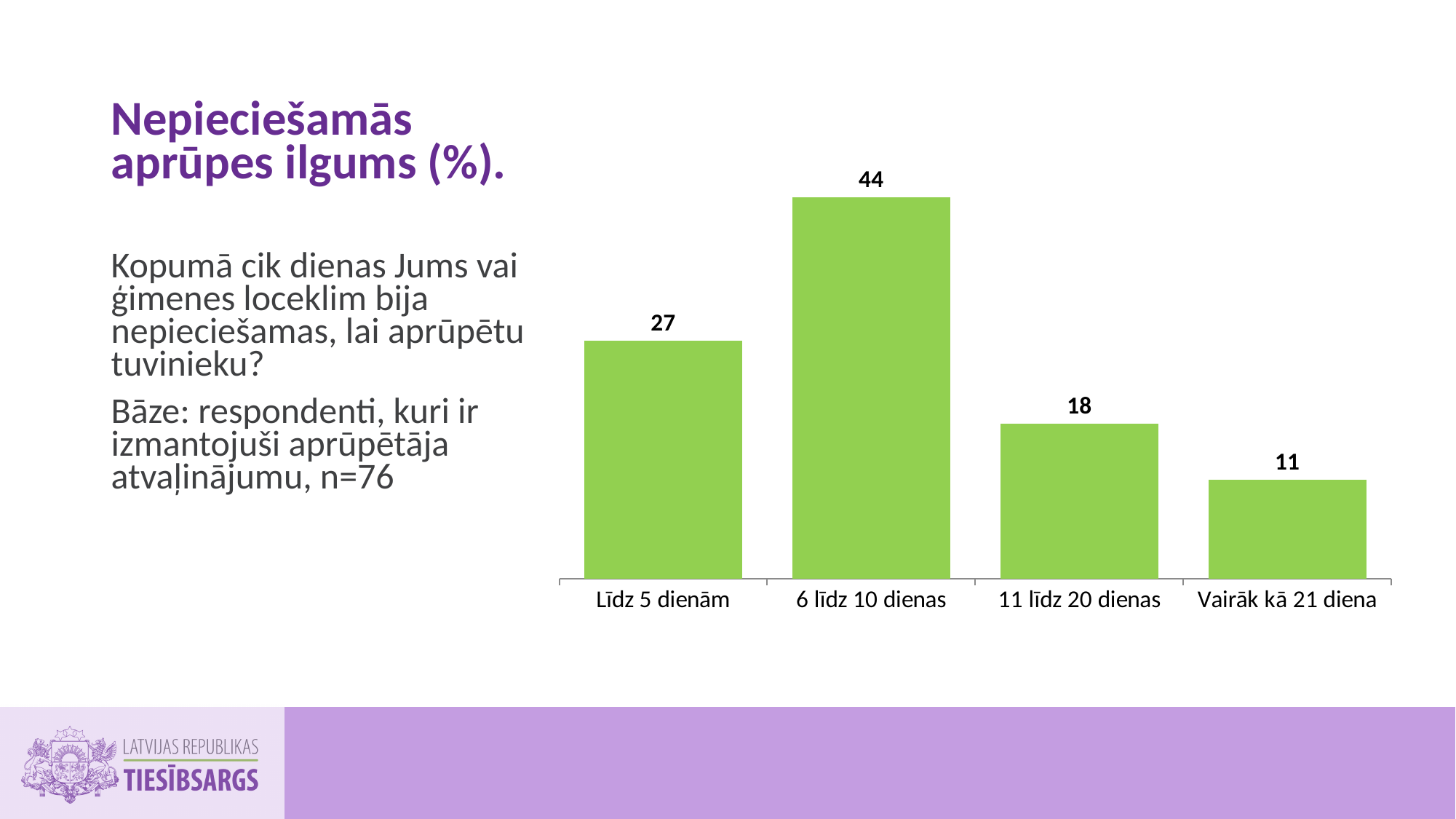
What is the title of the chart on the slide? Nepieciešamās aprūpes ilgums (%). What is the value for "Līdz 5 dienām"? 27 What is the value for "6 līdz 10 dienas"? 44 What is the value for "Vairāk kā 21 diena"? 11 How many categories are shown in the chart? 4 Which category has the highest value? 6 līdz 10 dienas What kind of chart is shown on the slide? Bar chart Which is larger: the value for "Līdz 5 dienām" or the value for "11 līdz 20 dienas"? Līdz 5 dienām What is the value for "11 līdz 20 dienas"? 18 Which category has the lowest value? Vairāk kā 21 diena What is the difference between the values for "11 līdz 20 dienas" and "Vairāk kā 21 diena"? 7 What is the difference between the values for "6 līdz 10 dienas" and "Līdz 5 dienām"? 17